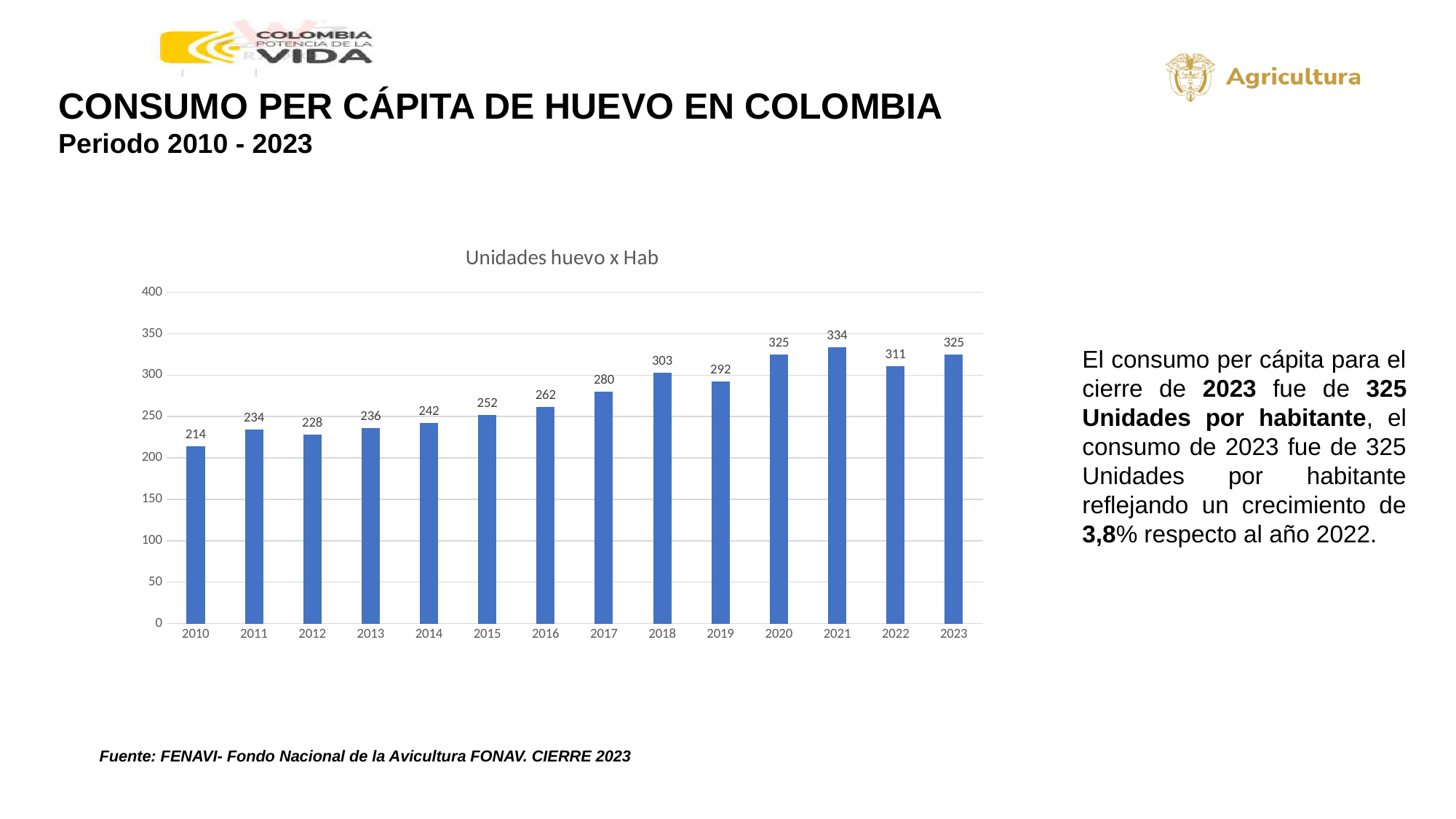
What kind of chart is shown on the slide? bar chart Is the value for 2016 greater or less than 250? greater What is the value for 2010 in the chart? 214 What is the difference between the values for 2021 and 2022? 23 What is the difference between the values for 2023 and 2010? 111 How many years are shown on the x axis of the chart? 14 Which is larger, the value for 2019 or the value for 2018? 2018 What is the value for 2022 in the chart? 311 Which year has the lowest value in the chart? 2010 What is the title of the chart? Unidades huevo x Hab Which year has the highest value in the chart? 2021 What is the value for 2018 in the chart? 303